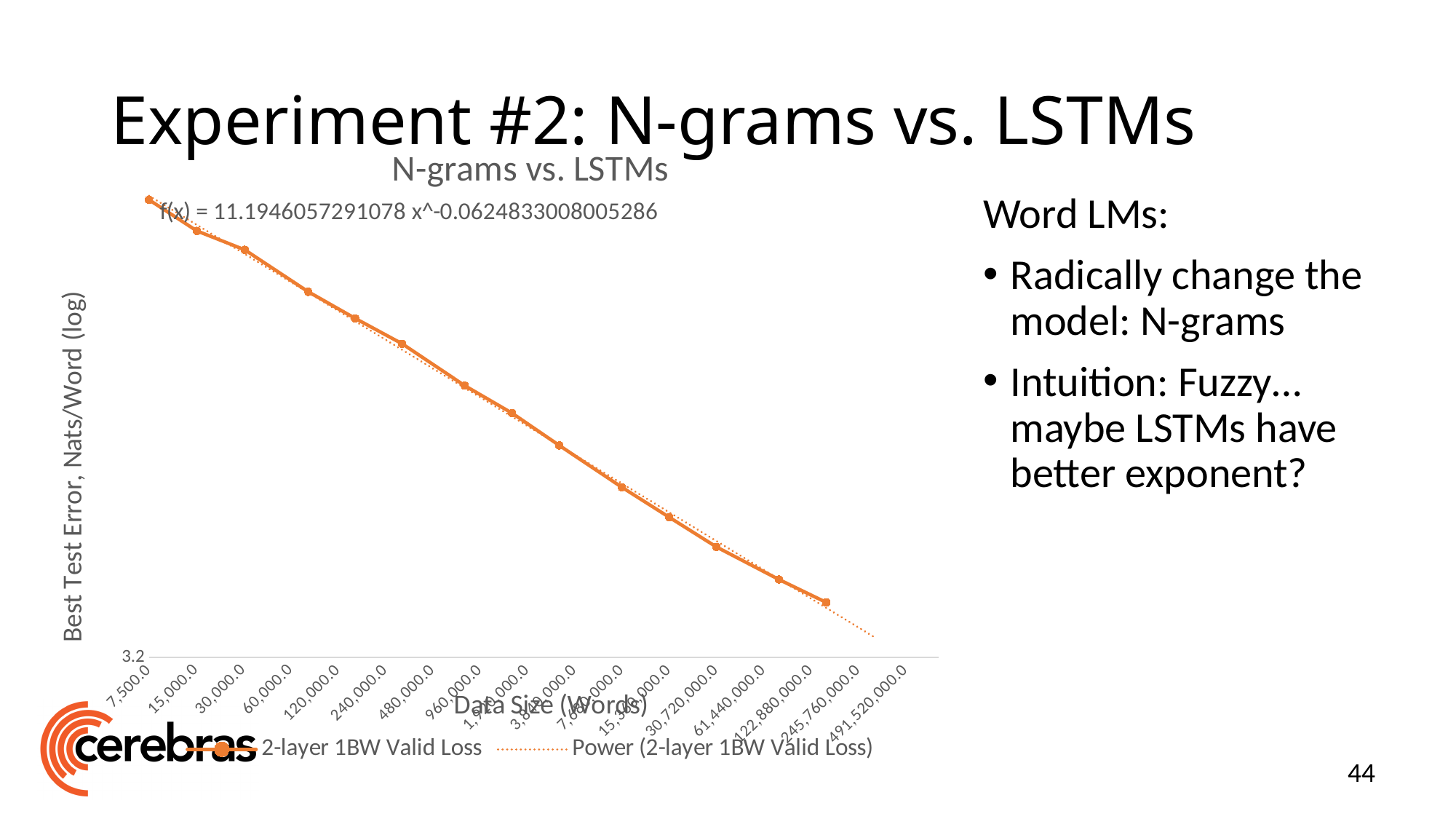
What is the label of the x axis? Data Size (Words) Is the 2-layer 1BW Valid Loss at 7,500.0 words greater or less than 3.2? greater What is the title of the chart? N-grams vs. LSTMs Which is larger, the 2-layer 1BW Valid Loss at 7,500.0 words or at 30,720,000.0 words? 7,500.0 Do the values of the 2-layer 1BW Valid Loss series rise or fall as data size increases along the x axis? fall How many data size categories are labelled on the x axis? 17 What kind of chart is shown on the slide? line chart How many series does the chart legend list? 2 What is the fitted power-law equation printed on the chart? f(x) = 11.1946057291078 x^-0.0624833008005286 Does the lowest 2-layer 1BW Valid Loss occur at the smallest or the largest data size? largest At which data size is the 2-layer 1BW Valid Loss highest? 7,500.0